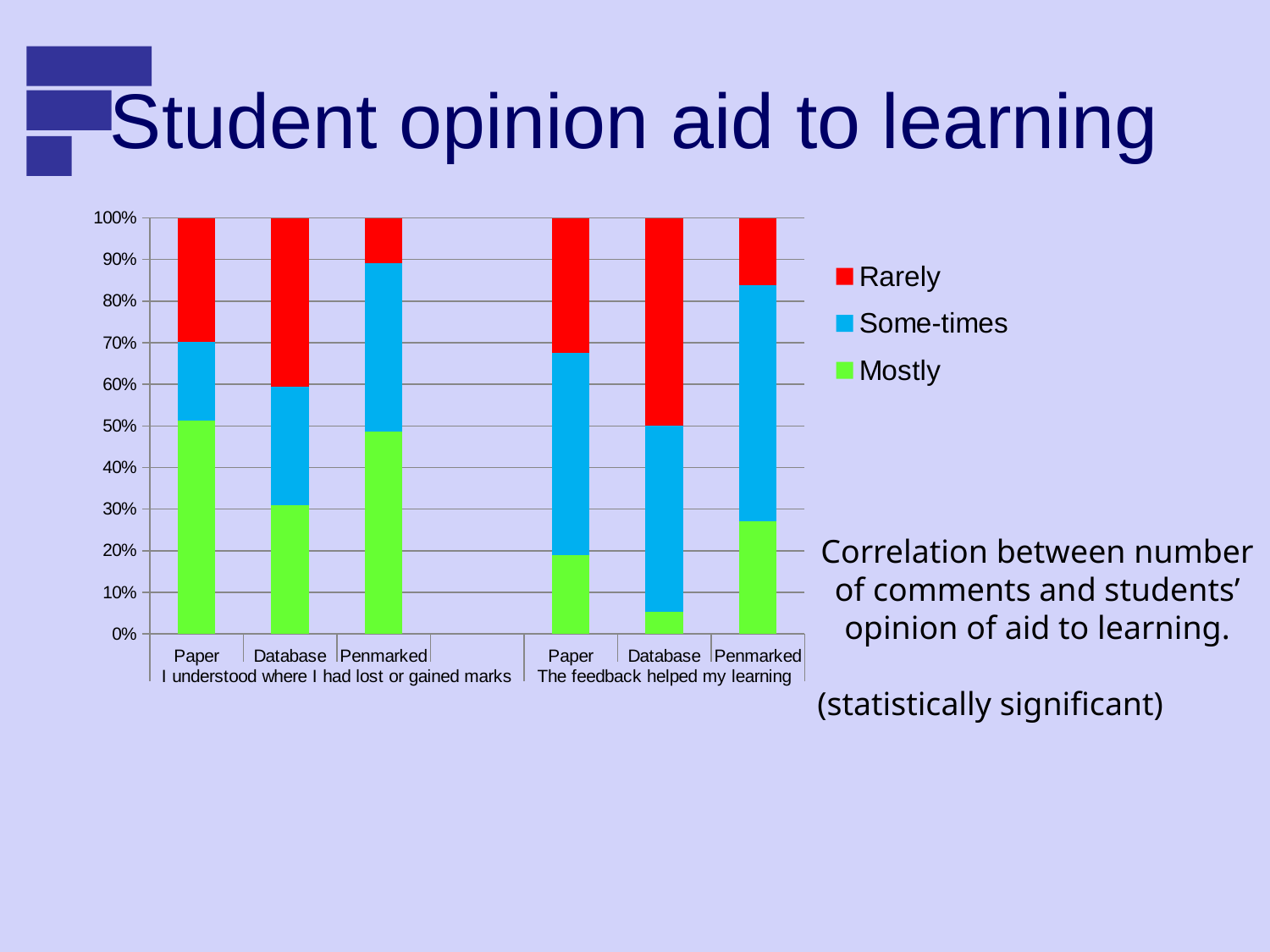
Which response category is shown in green in the legend? Mostly Which bar has the largest 'Rarely' segment? Database (The feedback helped my learning) Which has the larger 'Mostly' share: Database under 'I understood where I had lost or gained marks' or Database under 'The feedback helped my learning'? Database under 'I understood where I had lost or gained marks' How many series does the legend list? 3 How many bars are plotted in the chart? 6 Which bar has the smallest 'Mostly' segment? Database (The feedback helped my learning) Is the 'Mostly' share for Paper under 'I understood where I had lost or gained marks' greater or less than 40%? greater What are the two question groups labelled along the x axis? I understood where I had lost or gained marks; The feedback helped my learning Is the 'Mostly' share for Penmarked under 'The feedback helped my learning' greater or less than 20%? greater Is the 'Mostly' share for Database under 'The feedback helped my learning' greater or less than 10%? less What kind of chart is shown on the slide? Stacked bar chart Which bar has the smallest 'Rarely' segment? Penmarked (I understood where I had lost or gained marks)